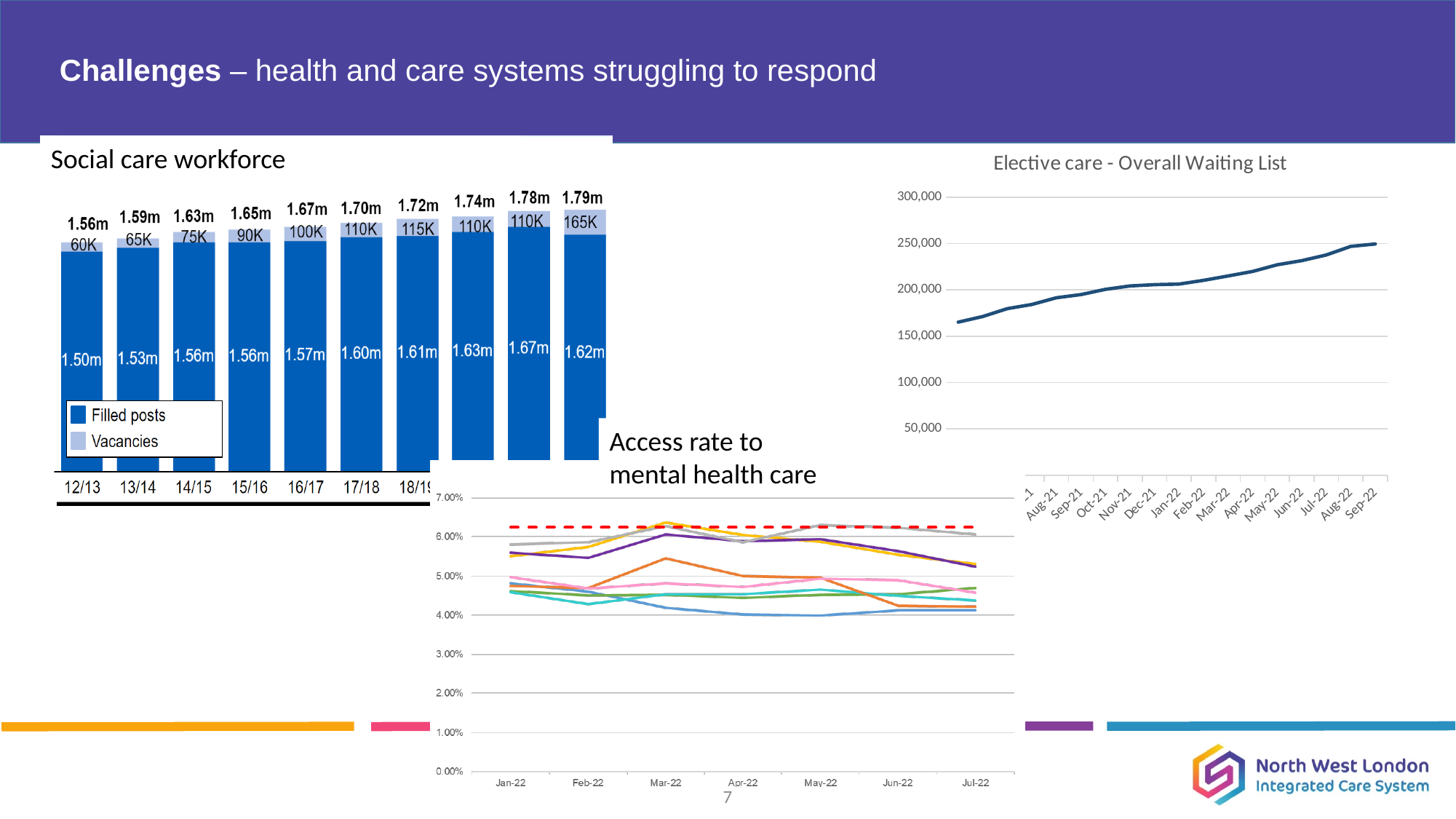
On the Social care workforce chart, how many vacancies are shown for 15/16? 90K On the Elective care - Overall Waiting List chart, is the value for Sep-22 greater or less than 200,000? greater On the Social care workforce chart, how many series does the legend list? 2 On the Social care workforce chart, what kind of chart is used? Stacked bar chart On the Access rate to mental health care chart, what kind of chart is used? Line chart On the Elective care - Overall Waiting List chart, is the value for Aug-21 greater or less than 200,000? less On the Social care workforce chart, what is the Filled posts value for 17/18? 1.60m On the Elective care - Overall Waiting List chart, does the waiting list rise or fall from Aug-21 to Sep-22? Rise On the Social care workforce chart, do the total workforce values rise or fall from 12/13 to 18/19? Rise On the Social care workforce chart, which of 12/13 or 18/19 has more vacancies? 18/19 On the Access rate to mental health care chart, how many months are shown on the x axis? 7 On the Social care workforce chart, what is the total workforce value shown for 14/15? 1.63m